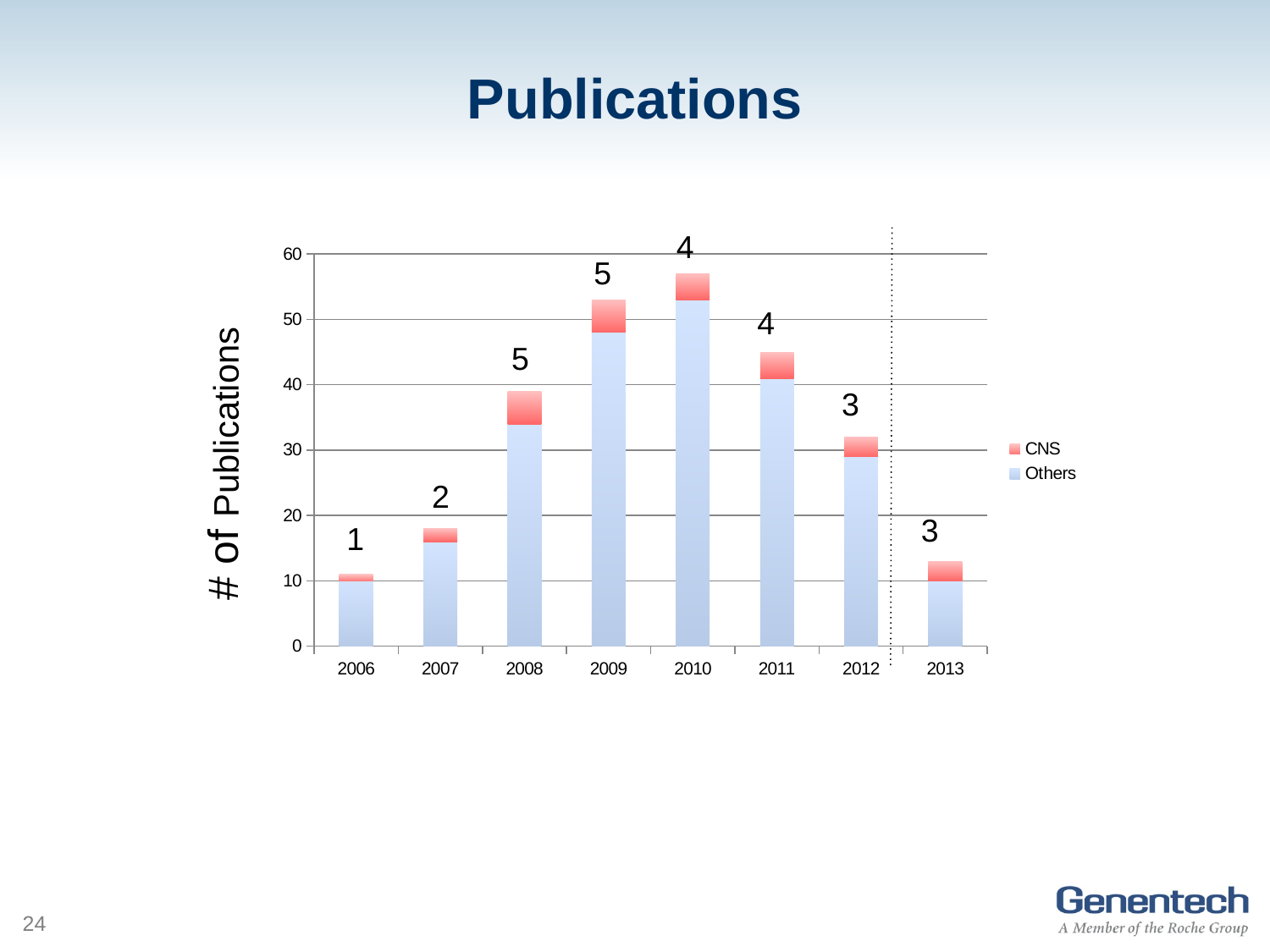
What is the difference between the CNS values for 2009 and 2007? 3 What is the CNS value for 2012? 3 How many series does the legend list? 2 Which year has the lowest CNS value? 2006 Which is larger, the CNS value for 2011 or for 2007? 2011 How many years are shown on the x axis? 8 Which year has the tallest total bar? 2010 What is the CNS value for 2006? 1 What is the CNS value for 2008? 5 What is the label of the y axis? # of Publications Is the total value for 2010 greater or less than 50? greater What kind of chart is shown on the slide? stacked bar chart